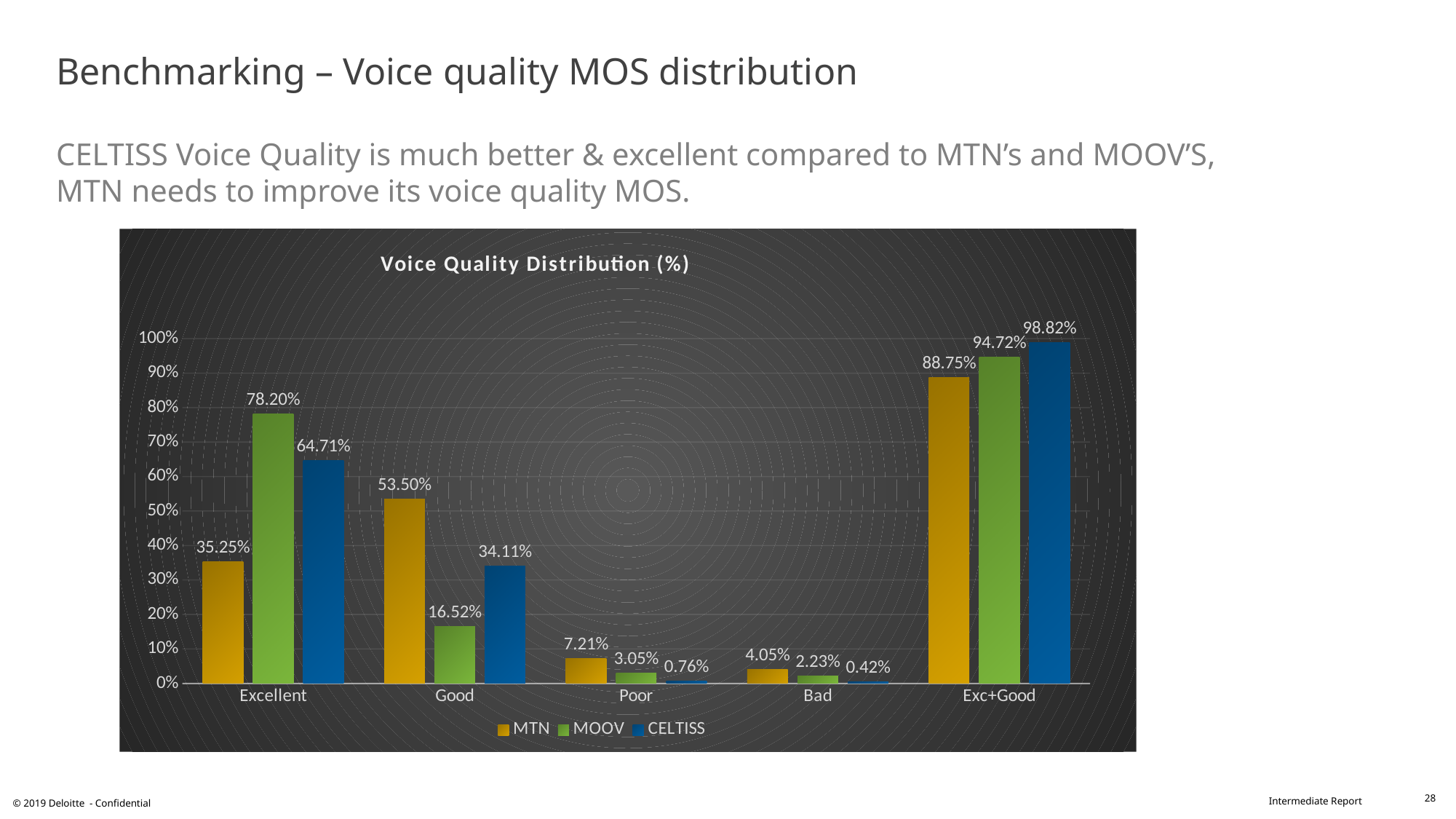
How many series does the legend list? 3 What is the value for MOOV in the Excellent category? 78.20% What is the value for MTN in the Good category? 53.50% What is the difference between the MOOV and MTN values in the Exc+Good category? 5.97% Which series has the lowest value in the Bad category? CELTISS Which series has the highest value in the Excellent category? MOOV Which is larger in the Good category, the MOOV value or the CELTISS value? CELTISS What is the value for CELTISS in the Exc+Good category? 98.82% How many categories are shown on the x axis? 5 What is the value for MTN in the Poor category? 7.21% What is the title of the chart? Voice Quality Distribution (%) What kind of chart is shown on the slide? Bar chart